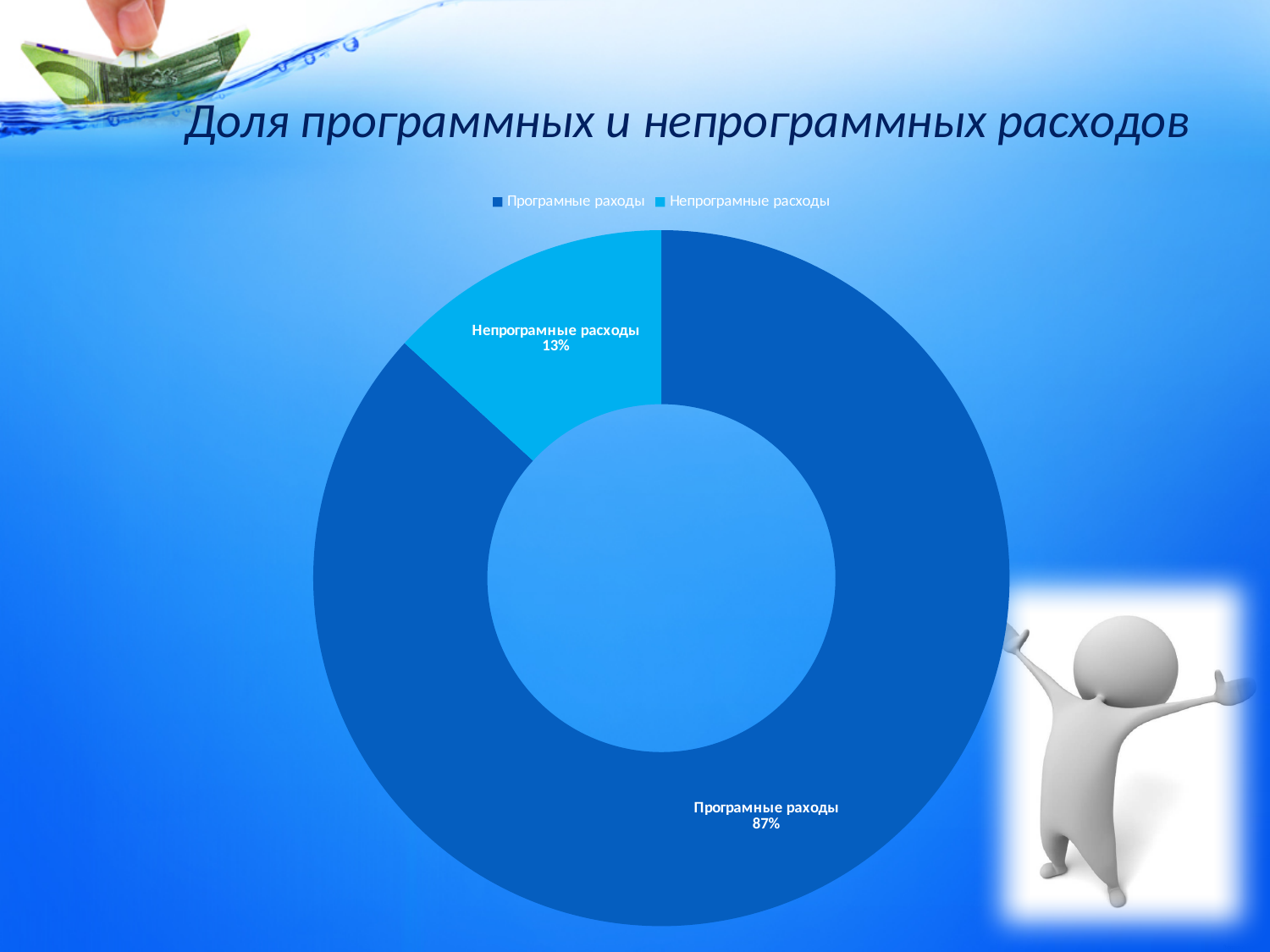
Which category has the smallest share in the chart? Непрограмные расходы Which is larger: the share for Програмные раходы or for Непрограмные расходы? Програмные раходы What is the title of the slide above the chart? Доля программных и непрограммных расходов What kind of chart is shown on the slide? Doughnut (pie) chart What is the difference in percentage points between Програмные раходы and Непрограмные расходы? 74 How many categories are shown in the chart? 2 Which category has the largest share in the chart? Програмные раходы What share of the doughnut chart is labelled Непрограмные расходы? 13% Which category is shown in the lighter cyan colour? Непрограмные расходы What share of the doughnut chart is labelled Програмные раходы? 87% How many entries does the legend list? 2